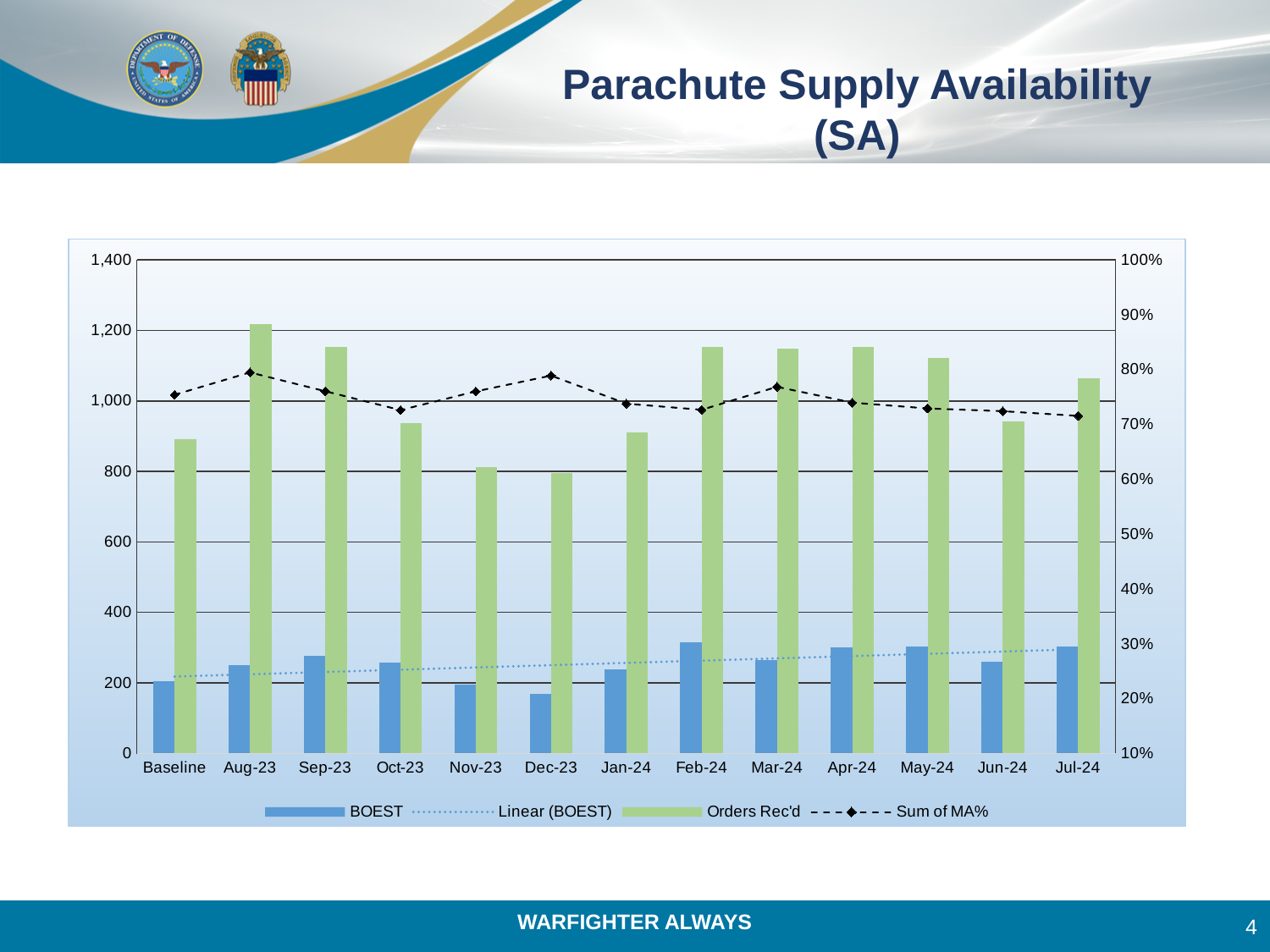
Which category has the lowest BOEST value? Dec-23 What kind of chart is shown on the slide? bar chart (with line series) Which is larger, the Orders Rec'd value for Aug-23 or for Oct-23? Aug-23 Does the Linear (BOEST) trendline rise or fall from Baseline to Jul-24? rise How many series does the chart legend list? 4 Is the BOEST value for Dec-23 greater or less than 200? less Is the Sum of MA% value for Jul-24 greater or less than 80%? less Which category has the highest Orders Rec'd value? Aug-23 How many categories are shown on the x axis of the chart? 13 Is the Orders Rec'd value for Baseline greater or less than 800? greater Which series in the legend is drawn as a dashed line with diamond markers? Sum of MA%